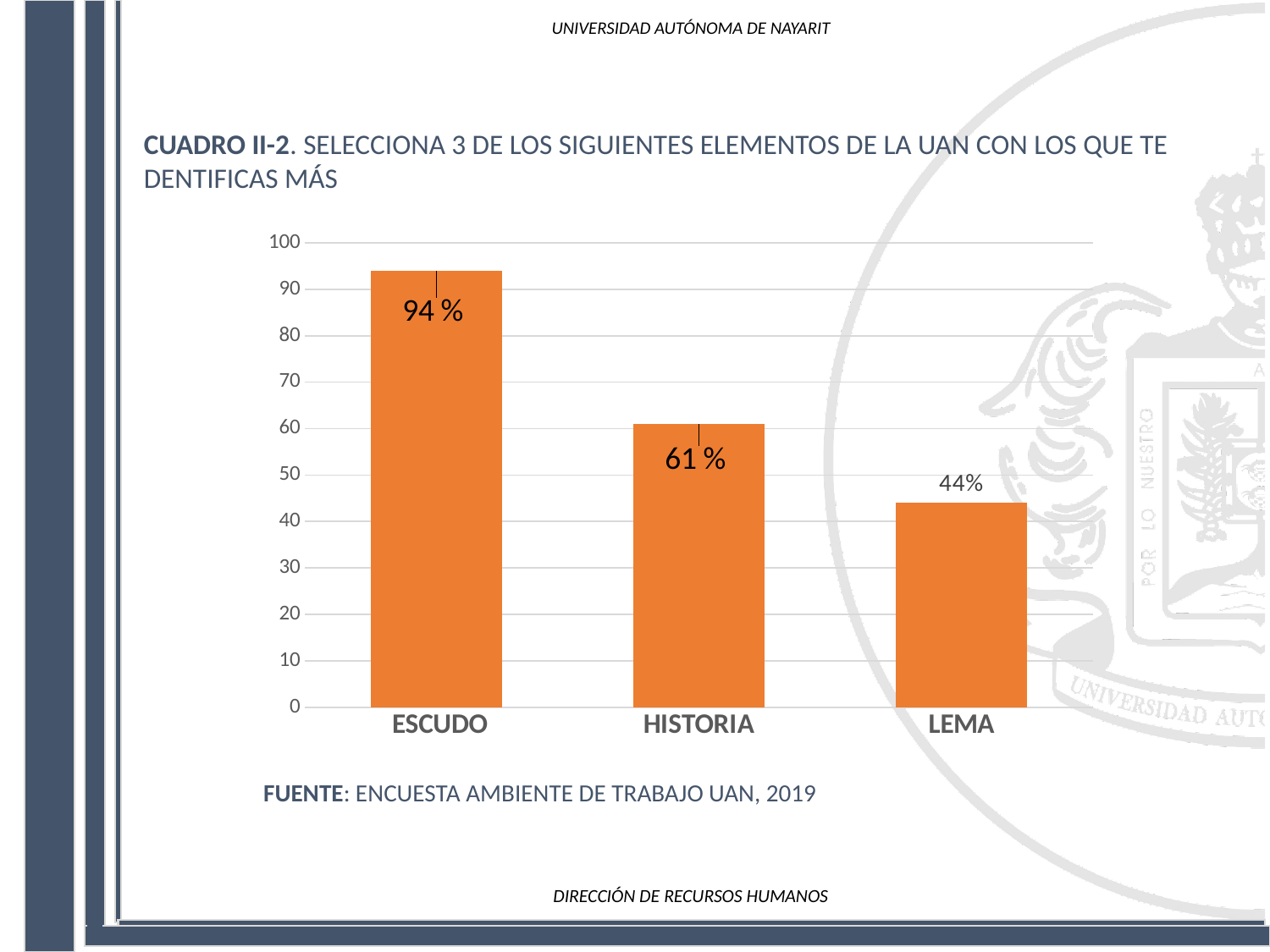
Which is larger, the value for HISTORIA or the value for LEMA? HISTORIA What is the difference between the values for ESCUDO and HISTORIA? 33 Do the values rise or fall from left to right along the x axis? fall What is the difference between the values for HISTORIA and LEMA? 17 Which category has the highest value? ESCUDO Is the value for LEMA greater or less than 50? less What kind of chart is shown on the slide? bar chart What is the value for LEMA? 44% What is the value for HISTORIA? 61 % What is the value for ESCUDO? 94 % Which category has the lowest value? LEMA How many categories are shown on the x axis? 3